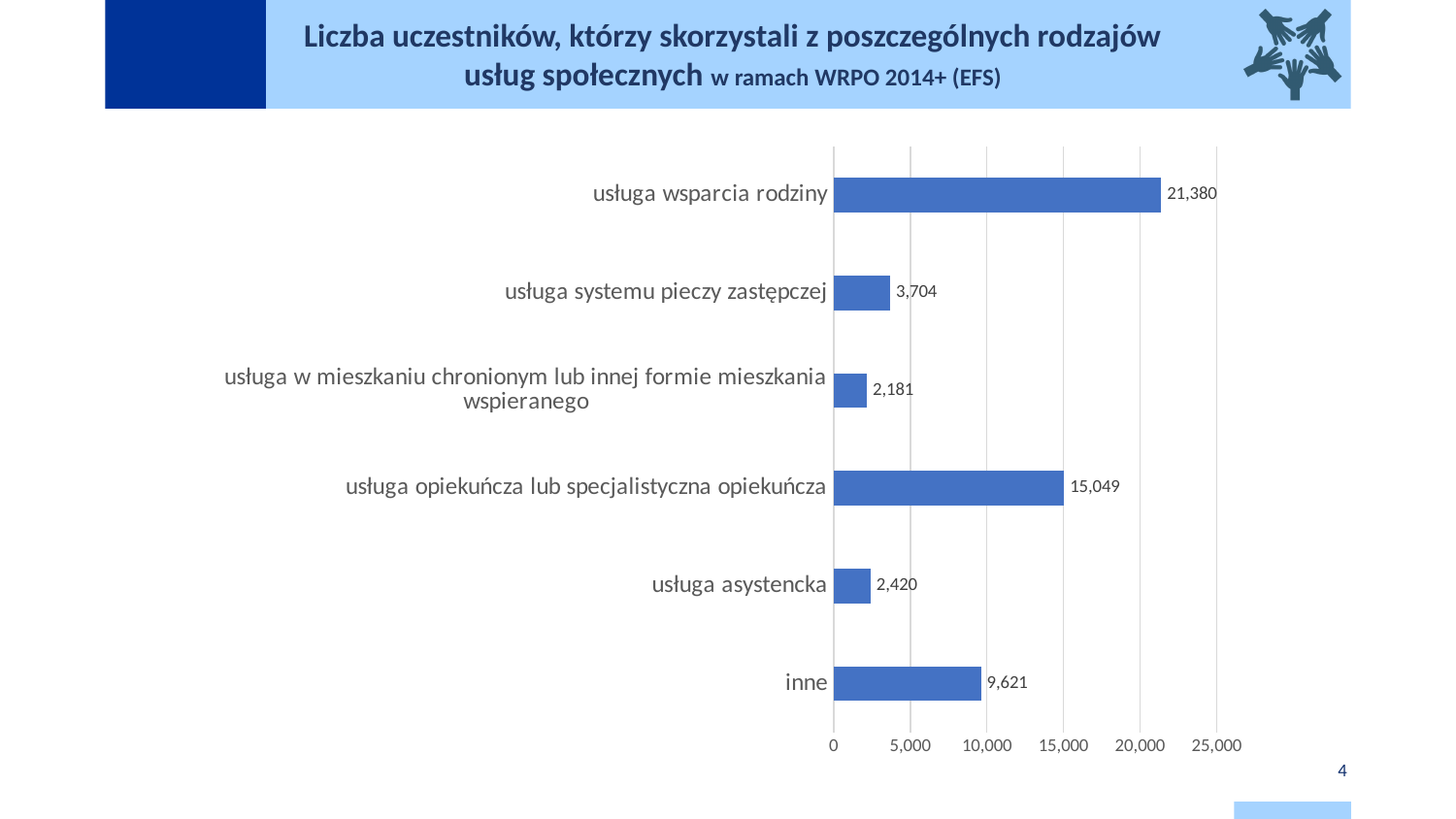
Which category has the highest value? usługa wsparcia rodziny What is the difference between the values for "usługa wsparcia rodziny" and "usługa opiekuńcza lub specjalistyczna opiekuńcza"? 6,331 Which is larger: the value for "inne" or the value for "usługa systemu pieczy zastępczej"? inne What kind of chart is shown on the slide? bar chart Which category has the lowest value? usługa w mieszkaniu chronionym lub innej formie mieszkania wspieranego How many categories are shown in the chart? 6 What is the value for "usługa wsparcia rodziny"? 21,380 Is the value for "usługa opiekuńcza lub specjalistyczna opiekuńcza" greater or less than 10,000? greater What is the difference between the values for "usługa systemu pieczy zastępczej" and "usługa asystencka"? 1,284 What is the value for "usługa opiekuńcza lub specjalistyczna opiekuńcza"? 15,049 What is the value for "usługa asystencka"? 2,420 What is the value for "inne"? 9,621